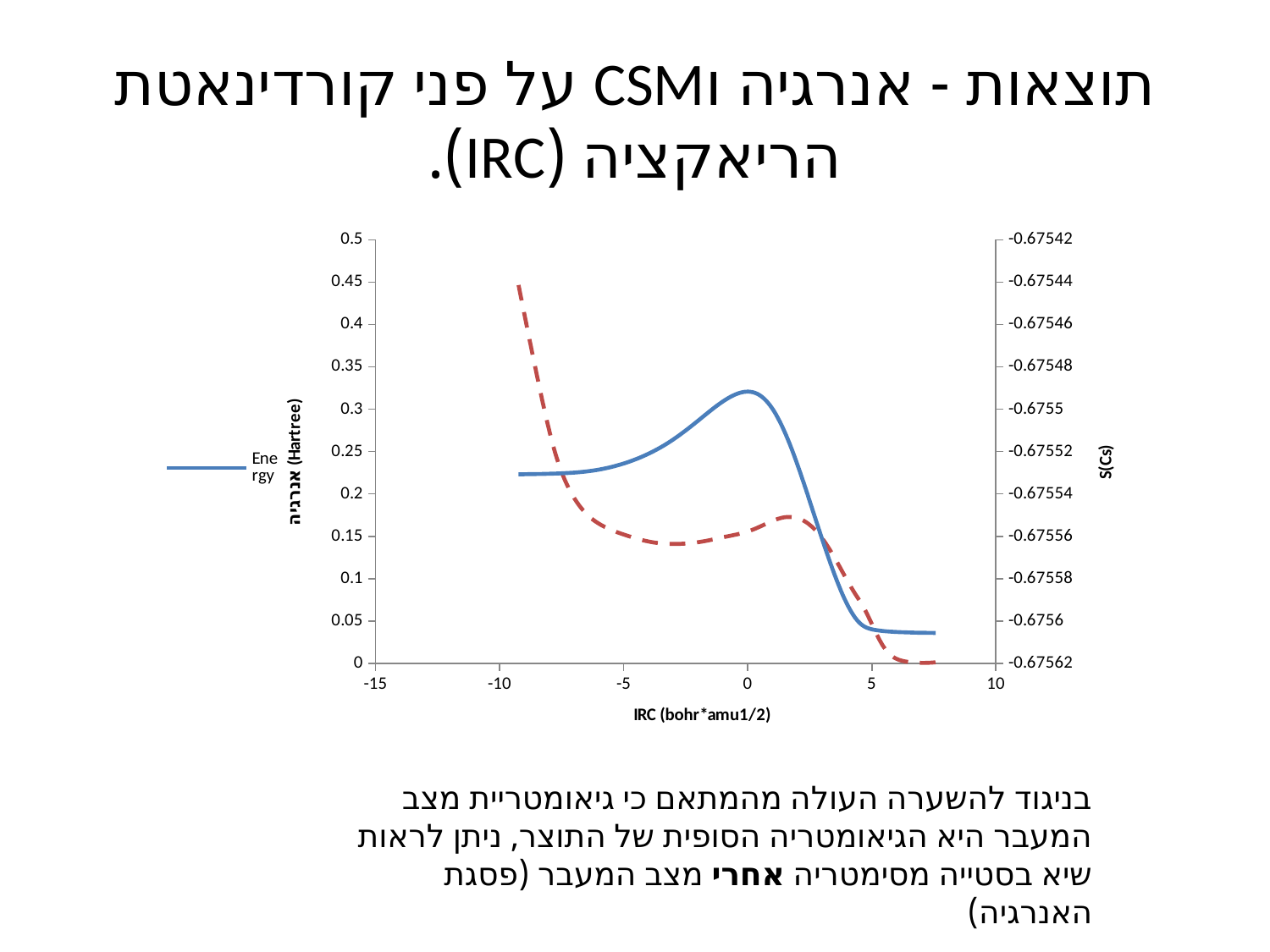
Does the solid Energy line rise or fall between IRC = 0 and IRC = 5? fall At which labelled IRC tick does the solid Energy line reach its highest value? 0 What is the title of the x axis of the chart? IRC (bohr*amu1/2) Is the solid Energy line higher at IRC = -5 or at IRC = 5? IRC = -5 How many series does the chart's legend list? 1 What kind of chart is shown on the slide? line chart What is the name of the series listed in the chart's legend? Energy Does the solid Energy line rise or fall between IRC = -5 and IRC = 0? rise